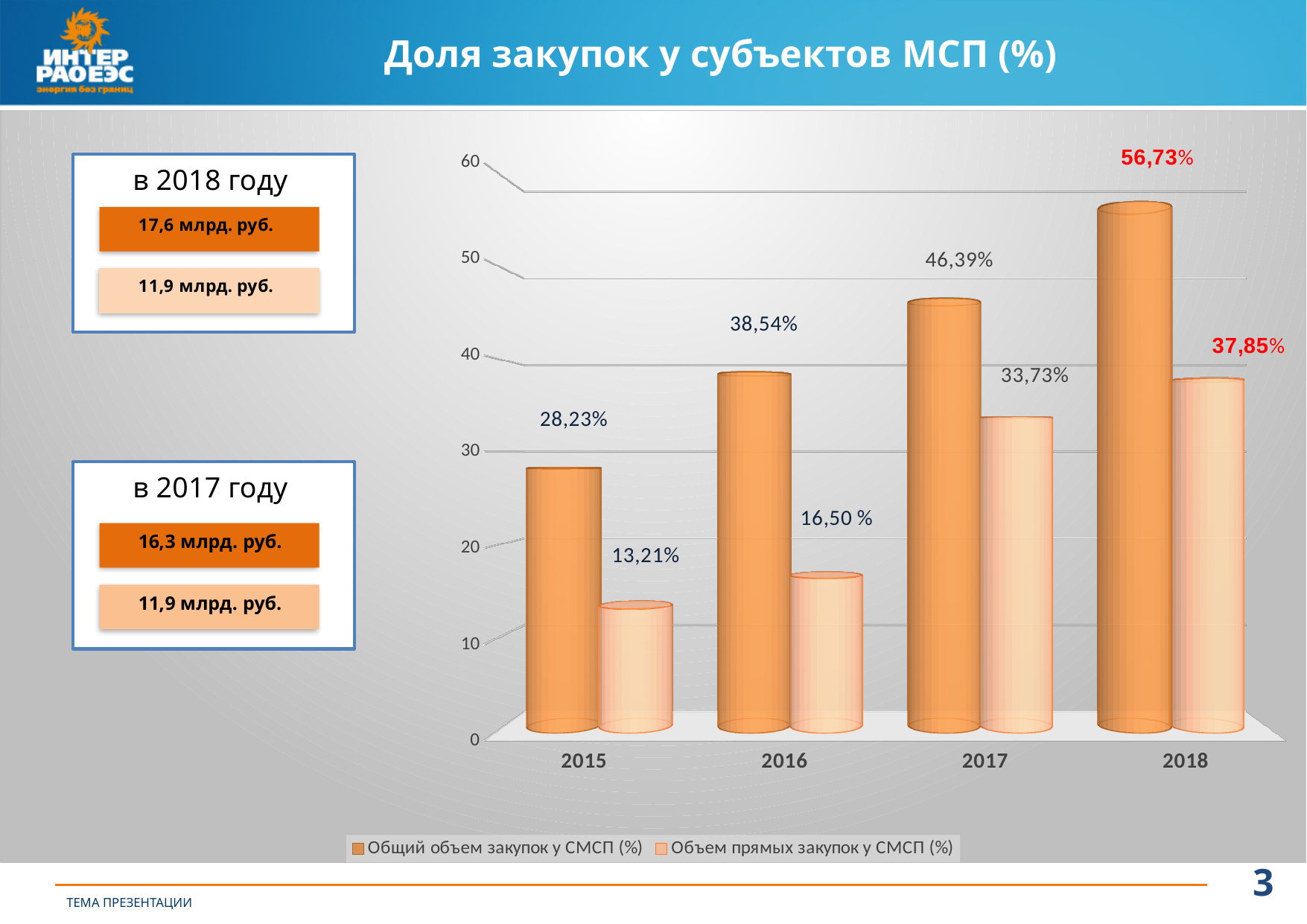
Which year has the lowest value for Объем прямых закупок у СМСП (%)? 2015 What is the value of Общий объем закупок у СМСП (%) for 2016? 38,54% Which is larger in 2017: Общий объем закупок у СМСП (%) or Объем прямых закупок у СМСП (%)? Общий объем закупок у СМСП (%) What is the value of Общий объем закупок у СМСП (%) for 2018? 56,73% How many series does the chart legend list? 2 What is the value of Объем прямых закупок у СМСП (%) for 2017? 33,73% Is the value of Общий объем закупок у СМСП (%) for 2017 greater or less than 40? greater Does the value of Общий объем закупок у СМСП (%) rise or fall from 2015 to 2018? rise How many years are shown on the x axis of the chart? 4 What is the value of Объем прямых закупок у СМСП (%) for 2015? 13,21% Which year has the highest value for Общий объем закупок у СМСП (%)? 2018 What is the difference between Общий объем закупок у СМСП (%) and Объем прямых закупок у СМСП (%) in 2018? 18,88%